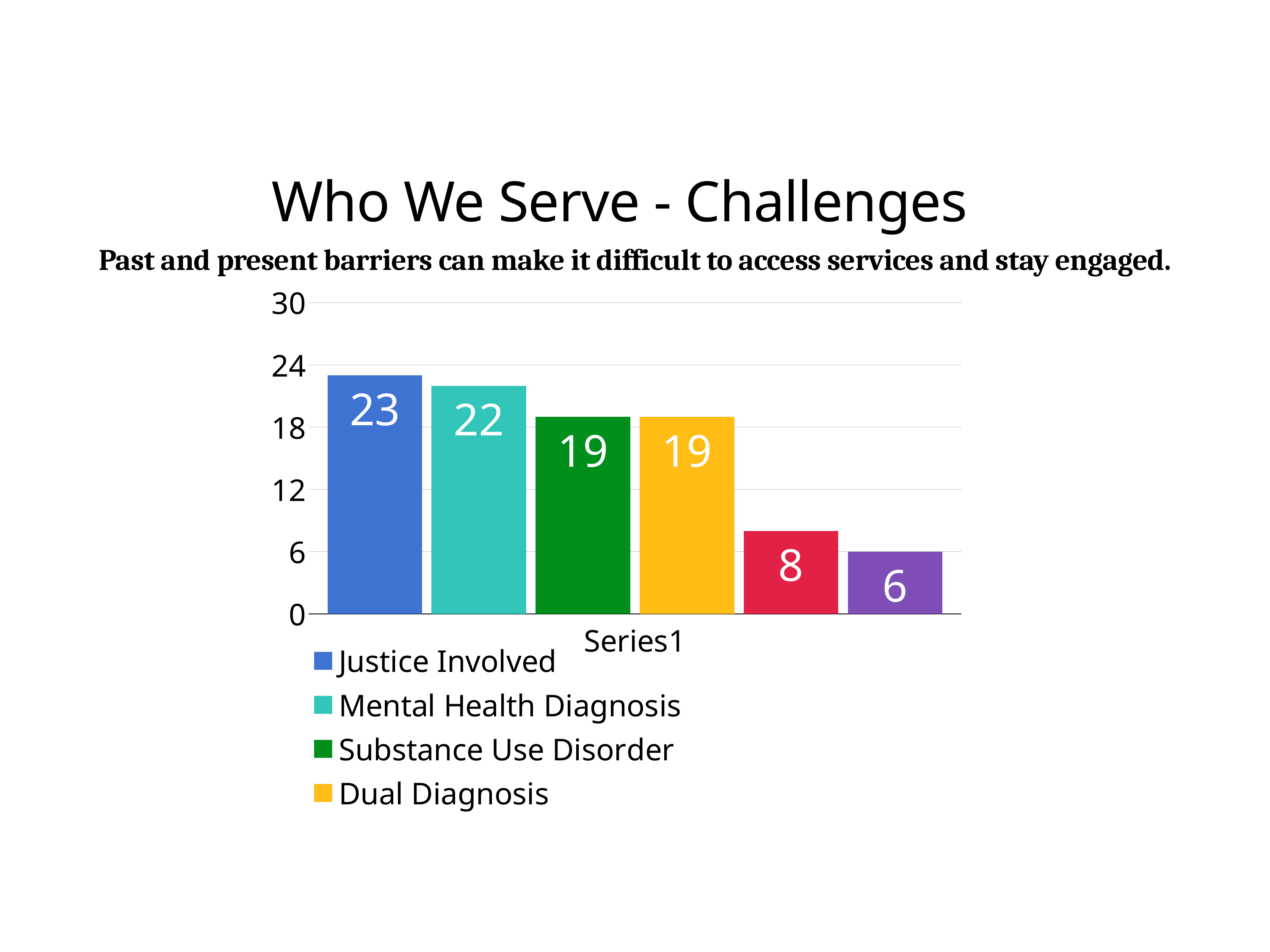
What is the value for Mental Health Diagnosis? 22 Is the value for Justice Involved greater or less than 18? greater How many bars are plotted in the chart? 6 Which legend entry has the highest value? Justice Involved What is the value for Justice Involved? 23 How many entries does the legend list? 4 What kind of chart is shown on the slide? bar chart What is the value for Dual Diagnosis? 19 What is the difference between the values for Justice Involved and Substance Use Disorder? 4 Which is larger, the value for Mental Health Diagnosis or the value for Dual Diagnosis? Mental Health Diagnosis What is the title of the slide? Who We Serve - Challenges What is the value for Substance Use Disorder? 19